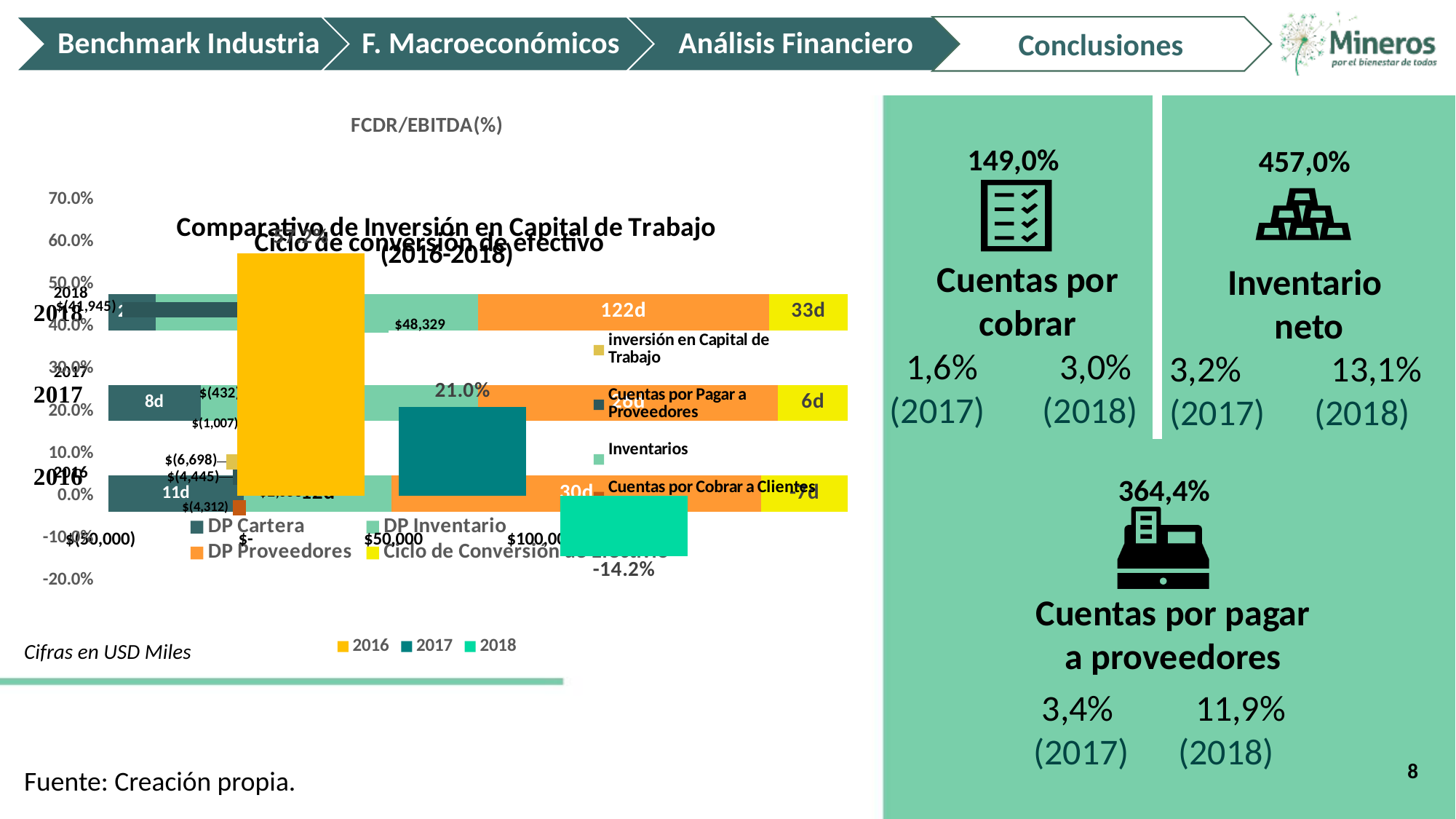
In the Ciclo de conversión de efectivo chart, which year has the highest Ciclo de Conversión de Efectivo value? 2018 In the FCDR/EBITDA(%) chart, what is the difference between the 2016 and 2017 values? 36.2 percentage points In the FCDR/EBITDA(%) chart, what is the value for 2016? 57.2% How many entries does the legend of the Comparativo de Inversión en Capital de Trabajo (2016-2018) chart list? 4 How many series does the legend of the FCDR/EBITDA(%) chart list? 3 In the Ciclo de conversión de efectivo chart, what is the DP Proveedores value for 2018? 122d In the FCDR/EBITDA(%) chart, what is the value for 2018? -14.2% In the Ciclo de conversión de efectivo chart, which is larger, the DP Cartera value for 2016 or for 2017? 2016 In the FCDR/EBITDA(%) chart, do the values rise or fall from 2016 to 2018? fall In the Ciclo de conversión de efectivo chart, what is the DP Cartera value for 2017? 8d In the Ciclo de conversión de efectivo chart, what is the Ciclo de Conversión de Efectivo value for 2018? 33d In the FCDR/EBITDA(%) chart, which year has the lowest value? 2018